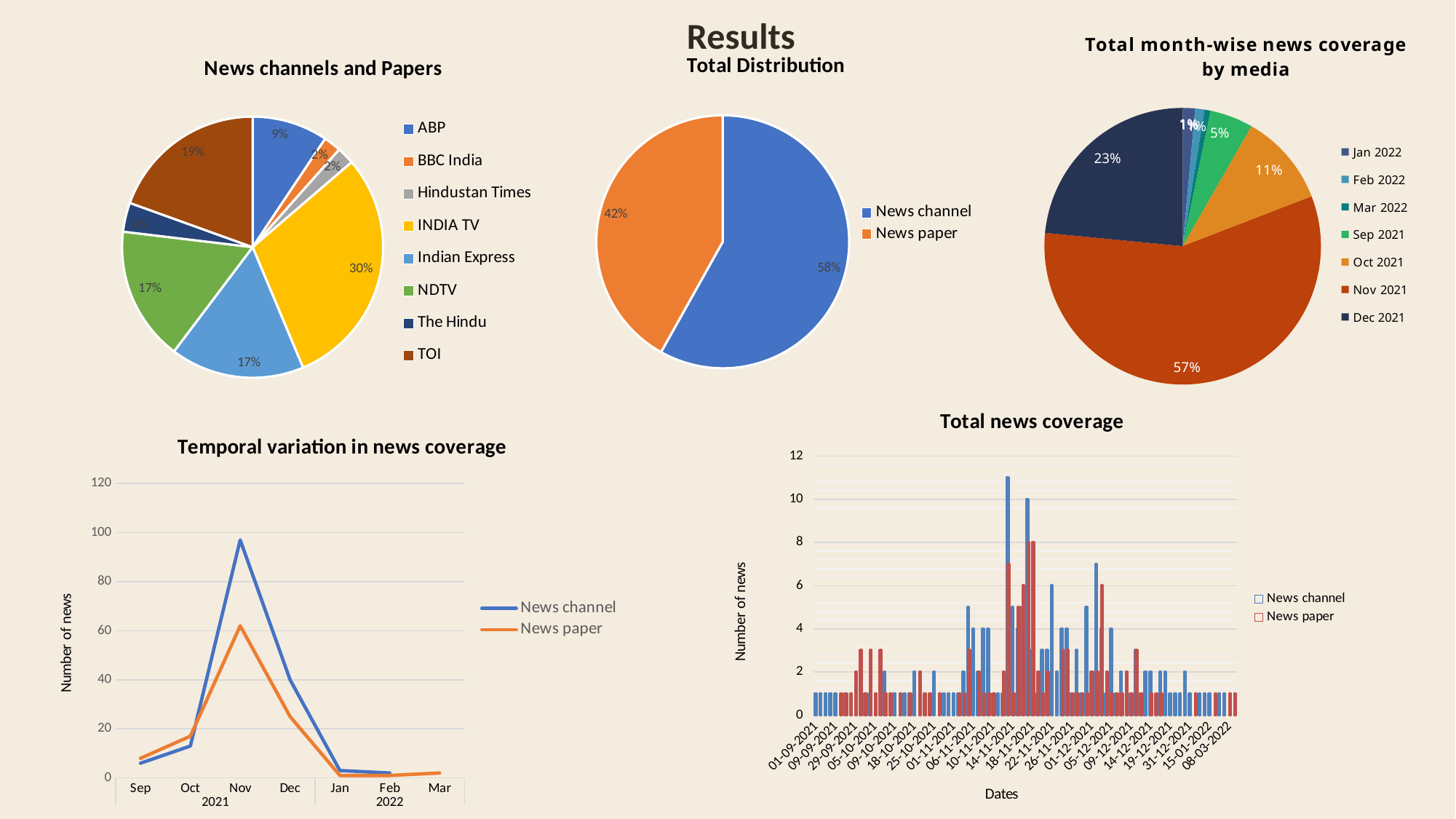
In the 'News channels and Papers' pie chart, what share does INDIA TV have? 30% In the 'Total month-wise news coverage by media' pie chart, what share does Nov 2021 have? 57% In the 'Temporal variation in news coverage' chart, do the values rise or fall from Nov to Dec? fall In the 'Total Distribution' pie chart, what share is News paper? 42% How many categories does the legend of the 'News channels and Papers' pie chart list? 8 In the 'Total Distribution' pie chart, which is larger, News channel or News paper? News channel What kind of chart is 'Temporal variation in news coverage'? Line chart In the 'News channels and Papers' pie chart, what is the difference between the shares of TOI and ABP? 10% In the 'News channels and Papers' pie chart, which category has the largest share? INDIA TV How many entries does the legend of the 'Total month-wise news coverage by media' pie chart list? 7 In the 'Total month-wise news coverage by media' pie chart, what is the difference between the shares of Dec 2021 and Oct 2021? 12% In the 'Temporal variation in news coverage' chart, is the News channel value for Nov greater or less than 80? greater